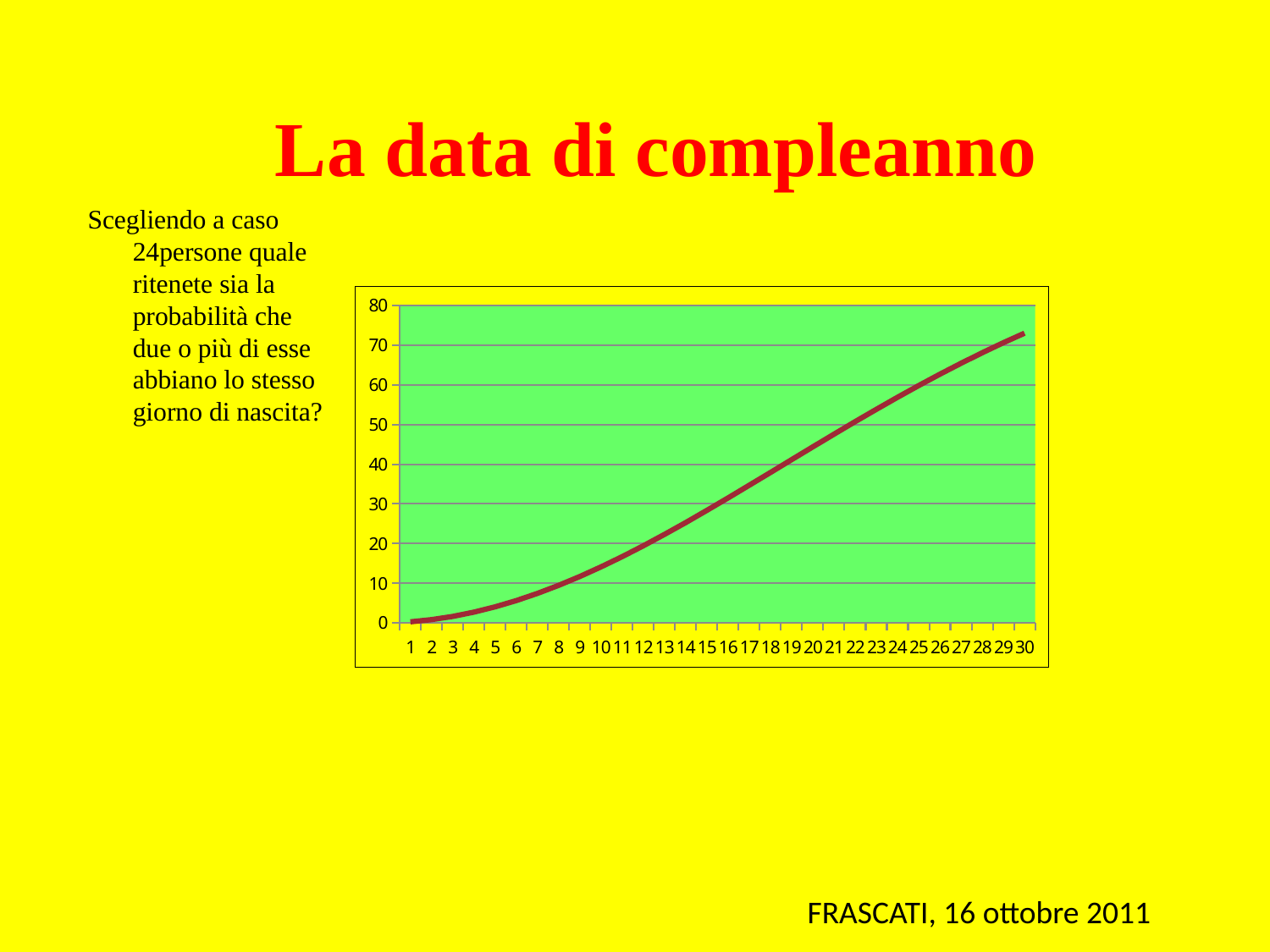
What is the highest value shown on the y axis of the chart? 80 Is the value at x = 25 greater or less than 50? greater Which has the larger value, x = 10 or x = 20? 20 Is the value at x = 30 greater or less than 80? less At which x value is the plotted value highest? 30 At which x value is the plotted value lowest? 1 Do the values on the chart rise or fall as the x axis goes from 1 to 30? rise How many points are plotted along the x axis of the chart? 30 What kind of chart is shown on the slide? line chart Is the value at x = 30 greater or less than 70? greater